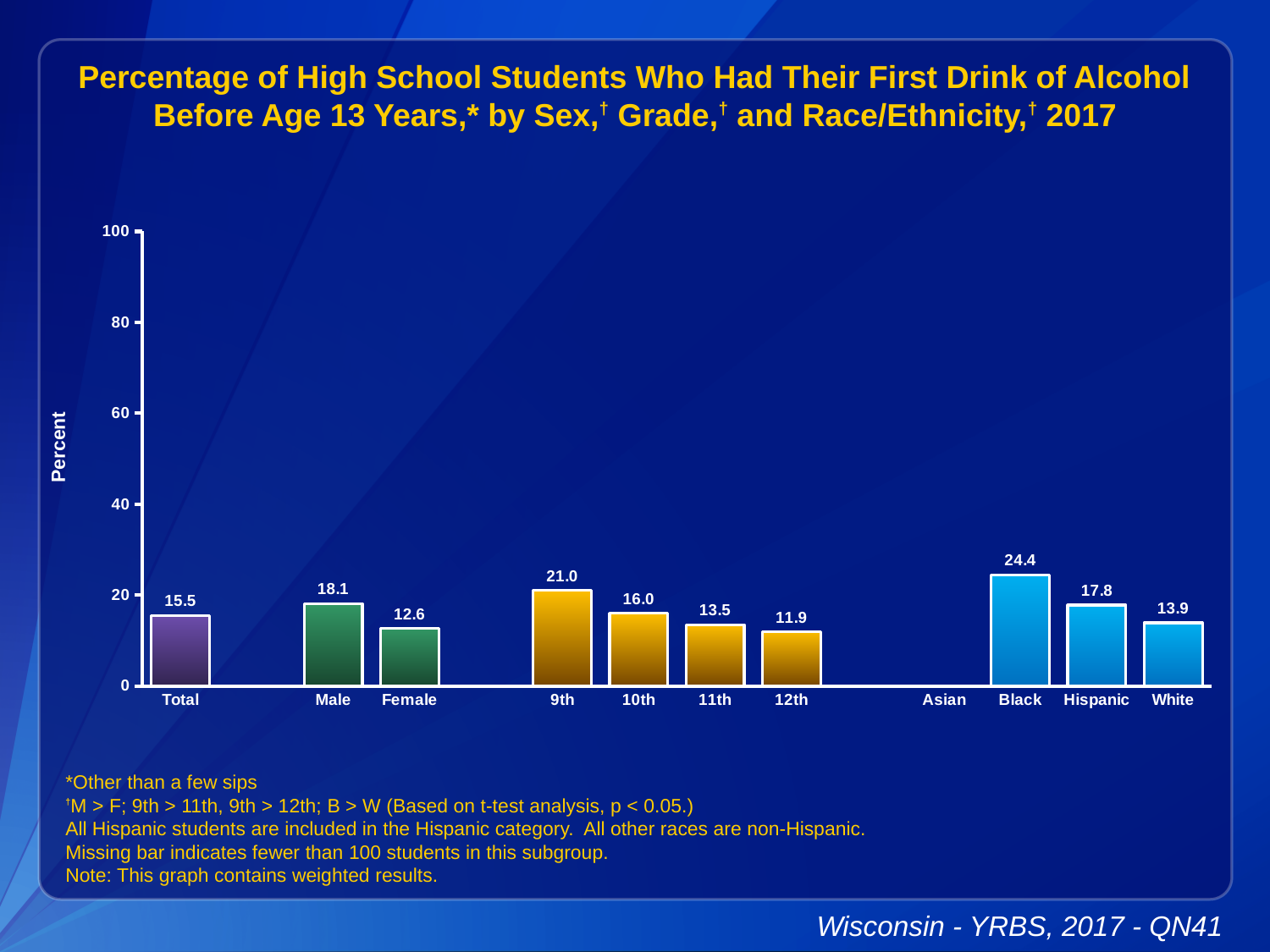
Which is larger, the value for Black or the value for White? Black What is the value for Male? 18.1 What is the value for Total? 15.5 What kind of chart is shown? bar chart Which category has the lowest plotted value? 12th How many bars are plotted on the chart? 10 What is the value for 9th grade? 21.0 What is the value for Hispanic? 17.8 What is the difference between the Male and Female values? 5.5 Which category has the highest value? Black Which category has no bar plotted? Asian Is the value for 9th grade greater or less than 20? greater